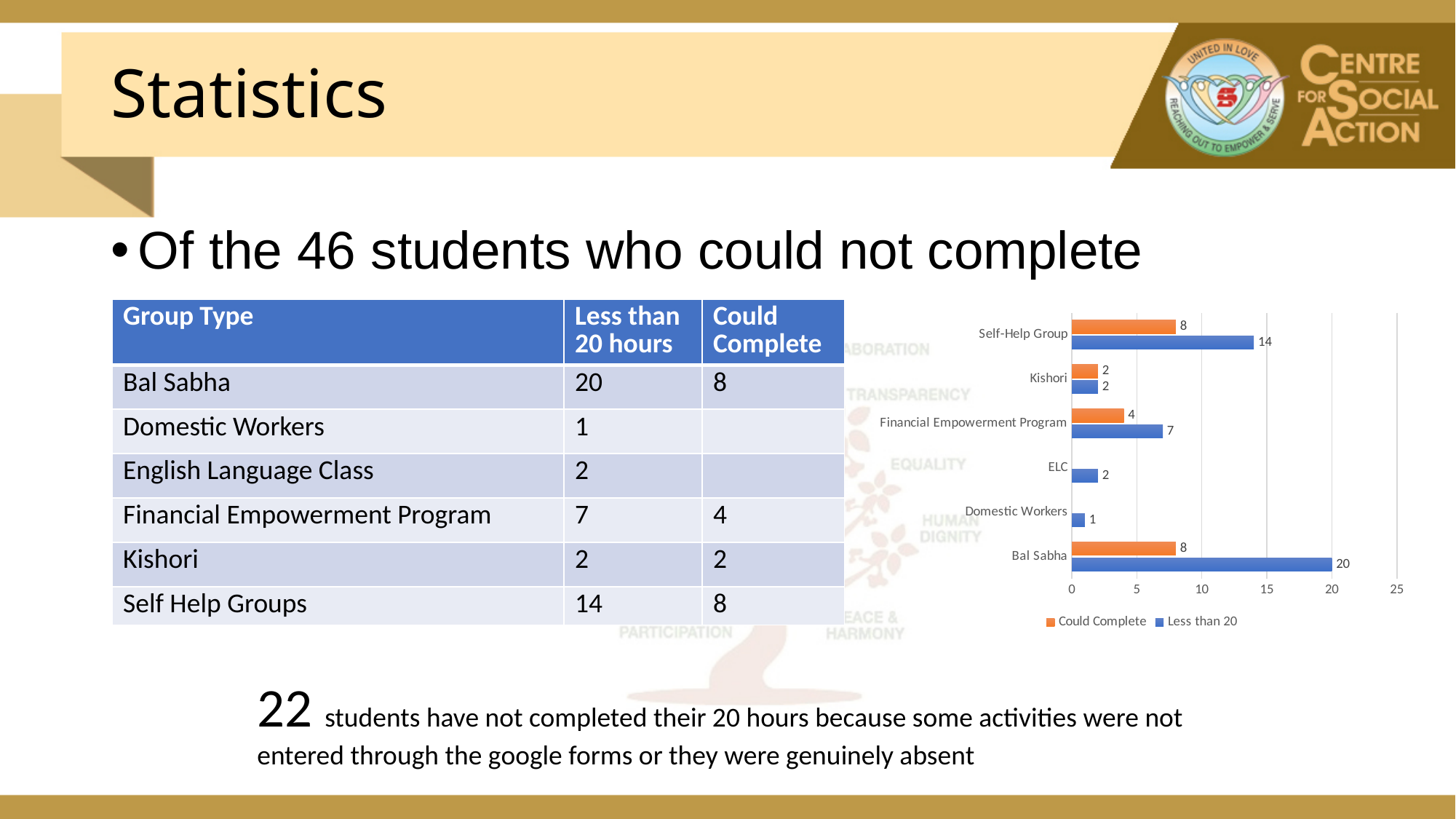
What kind of chart is shown on the slide? Bar chart How many series does the chart's legend list? 2 What are the two series named in the chart's legend? Could Complete and Less than 20 What is the 'Could Complete' value for Self-Help Group in the chart? 8 What is the 'Could Complete' value for Kishori in the chart? 2 Which is larger in the chart: the 'Less than 20' value for Self-Help Group or for Financial Empowerment Program? Self-Help Group Which category has the highest 'Less than 20' value in the chart? Bal Sabha Which category has the lowest 'Less than 20' value in the chart? Domestic Workers How many categories are shown on the chart's vertical axis? 6 What is the difference between the 'Less than 20' and 'Could Complete' values for Bal Sabha in the chart? 12 What is the 'Less than 20' value for Financial Empowerment Program in the chart? 7 What is the 'Less than 20' value for Bal Sabha in the chart? 20